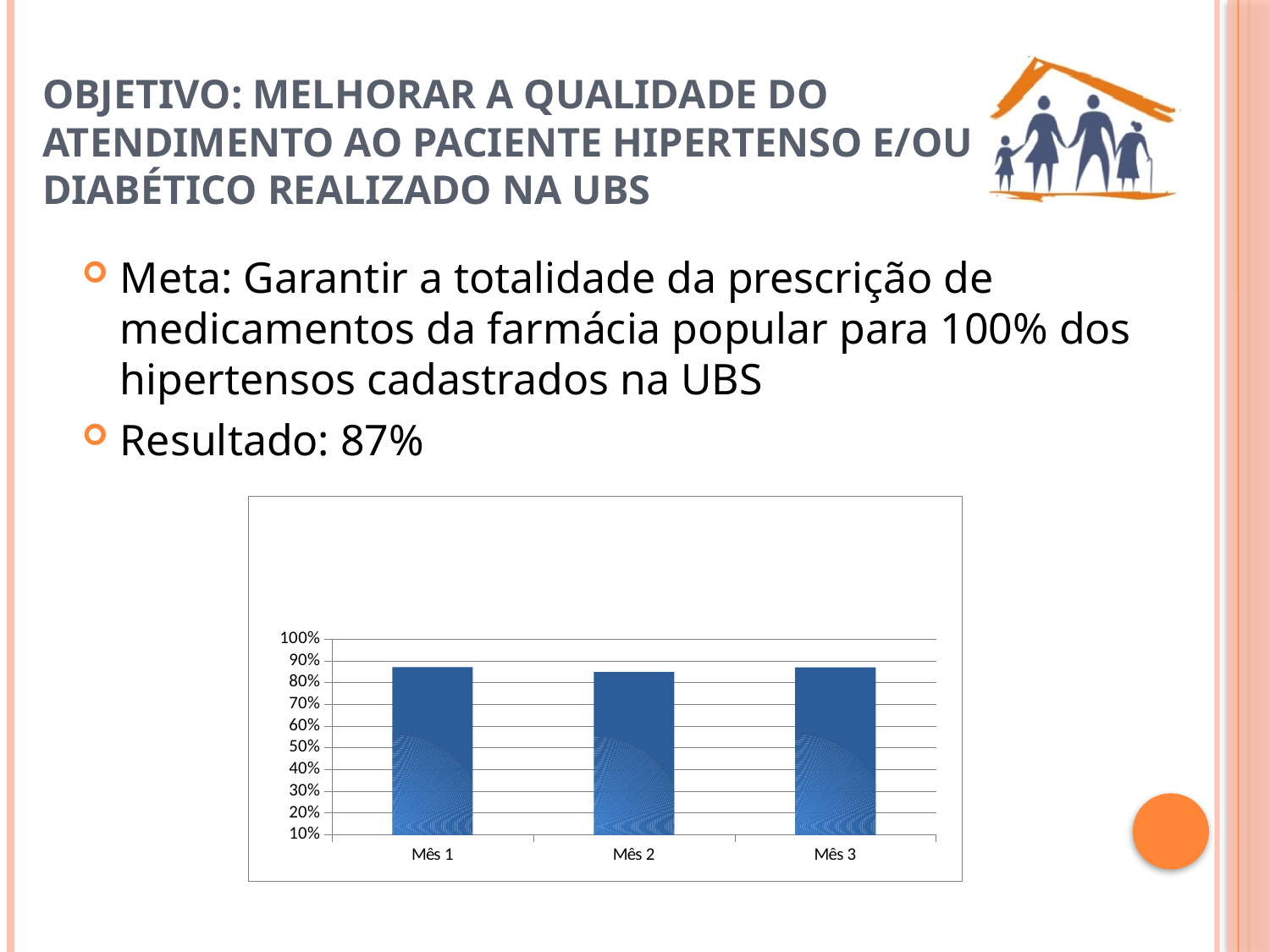
Is the value for Mês 3 greater or less than 90%? less Is the value for Mês 2 greater or less than 80%? greater What kind of chart is shown on the slide? bar chart Is the value for Mês 2 greater or less than 50%? greater How many categories are shown on the x axis of the chart? 3 What is the highest value shown on the y axis of the chart? 100% What are the category labels on the x axis of the chart? Mês 1, Mês 2, Mês 3